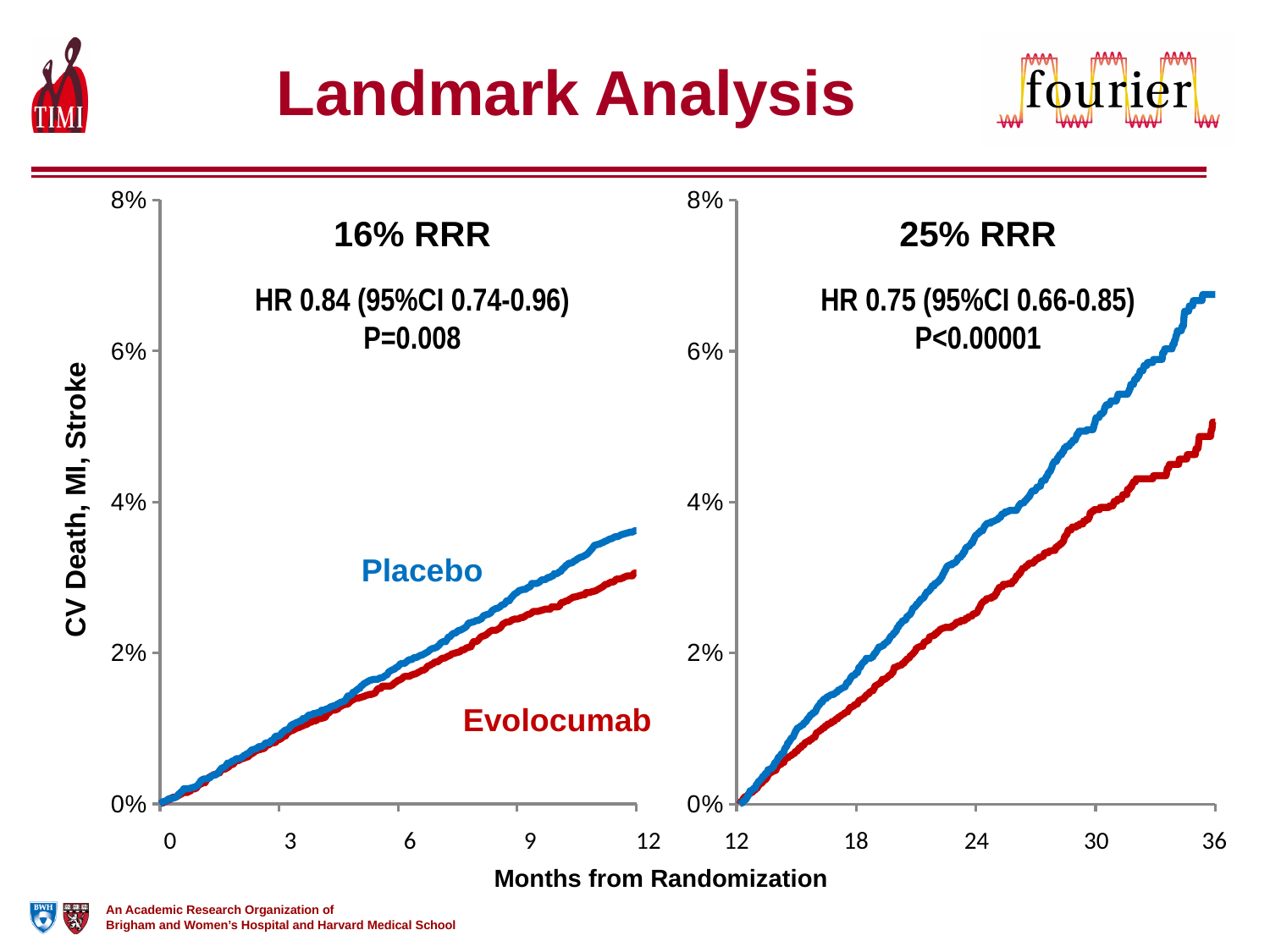
In the right chart (12 to 36 months), is the value for Placebo at 36 months greater or less than 6%? greater In the right chart (12 to 36 months), which series is lower at 36 months, Placebo or Evolocumab? Evolocumab How many tick labels are shown on the x axis of the right chart (12 to 36 months)? 5 In the right chart (12 to 36 months), is the value for Evolocumab at 36 months greater or less than 6%? less In the left chart (0 to 12 months), is the value for Placebo at 12 months greater or less than 4%? less What is the label of the shared x axis below the two charts? Months from Randomization What kind of chart is the left chart (0 to 12 months)? Line chart In the left chart (0 to 12 months), which series is higher at 12 months, Placebo or Evolocumab? Placebo In the right chart (12 to 36 months), do the Placebo values rise or fall as months increase? Rise In the right chart (12 to 36 months), how many series are plotted? 2 What is the y-axis label of the left chart? CV Death, MI, Stroke